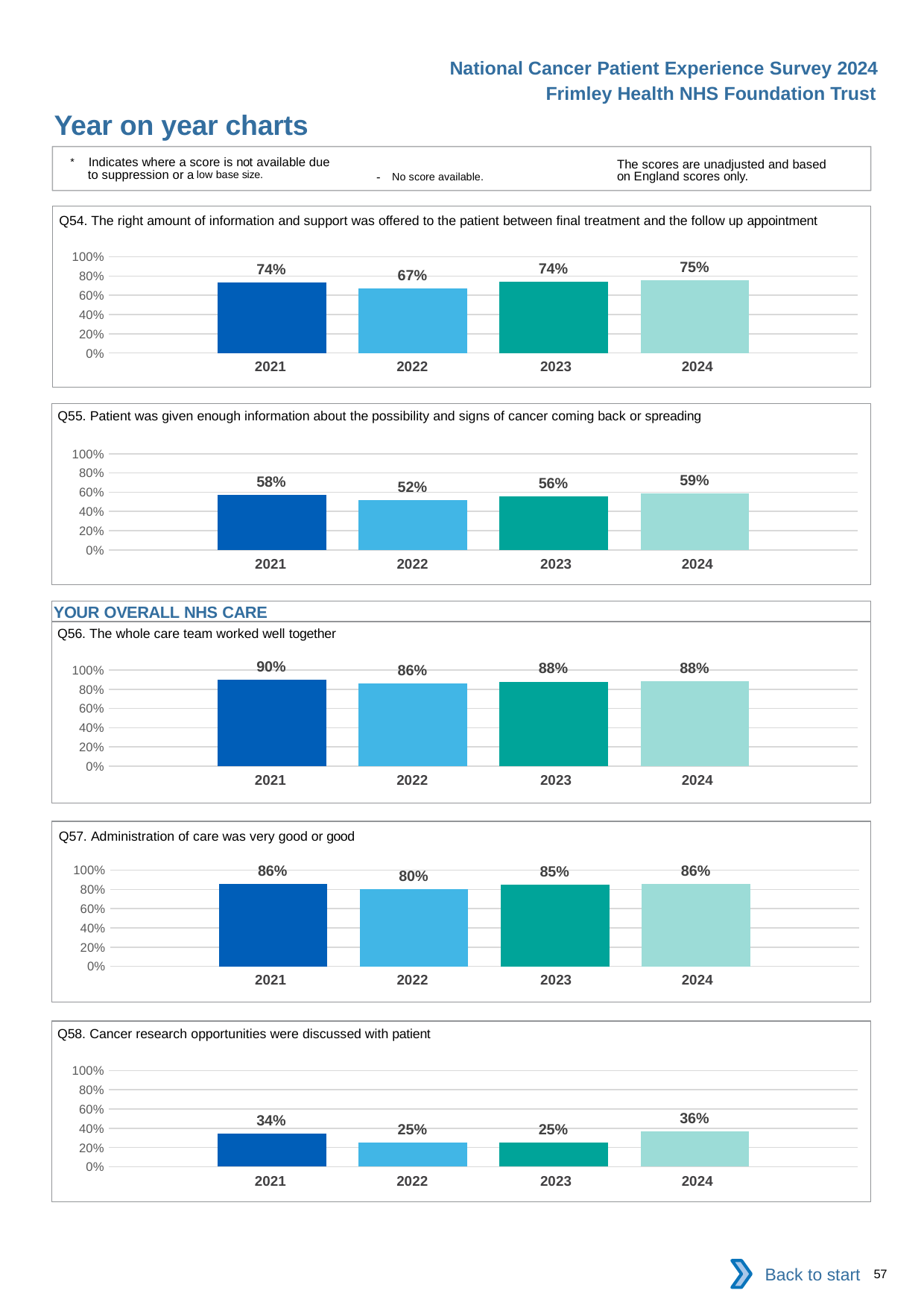
In the Q54 chart, which year has the highest value? 2024 How many years are shown on the x axis of the Q58 chart? 4 In the Q54 chart, what is the value for 2022? 67% In the Q57 chart, what is the value for 2023? 85% In the Q56 chart, what is the value for 2021? 90% What kind of chart is the Q54 chart? Bar chart In the Q58 chart, is the value for 2022 greater or less than 40%? less In the Q55 chart, which year has the lowest value? 2022 In the Q58 chart, which year has the highest value? 2024 In the Q57 chart, what is the difference between the 2021 value and the 2022 value? 6% In the Q56 chart, is the value for 2021 larger than the value for 2022? Yes In the Q55 chart, what is the difference between the 2024 value and the 2022 value? 7%